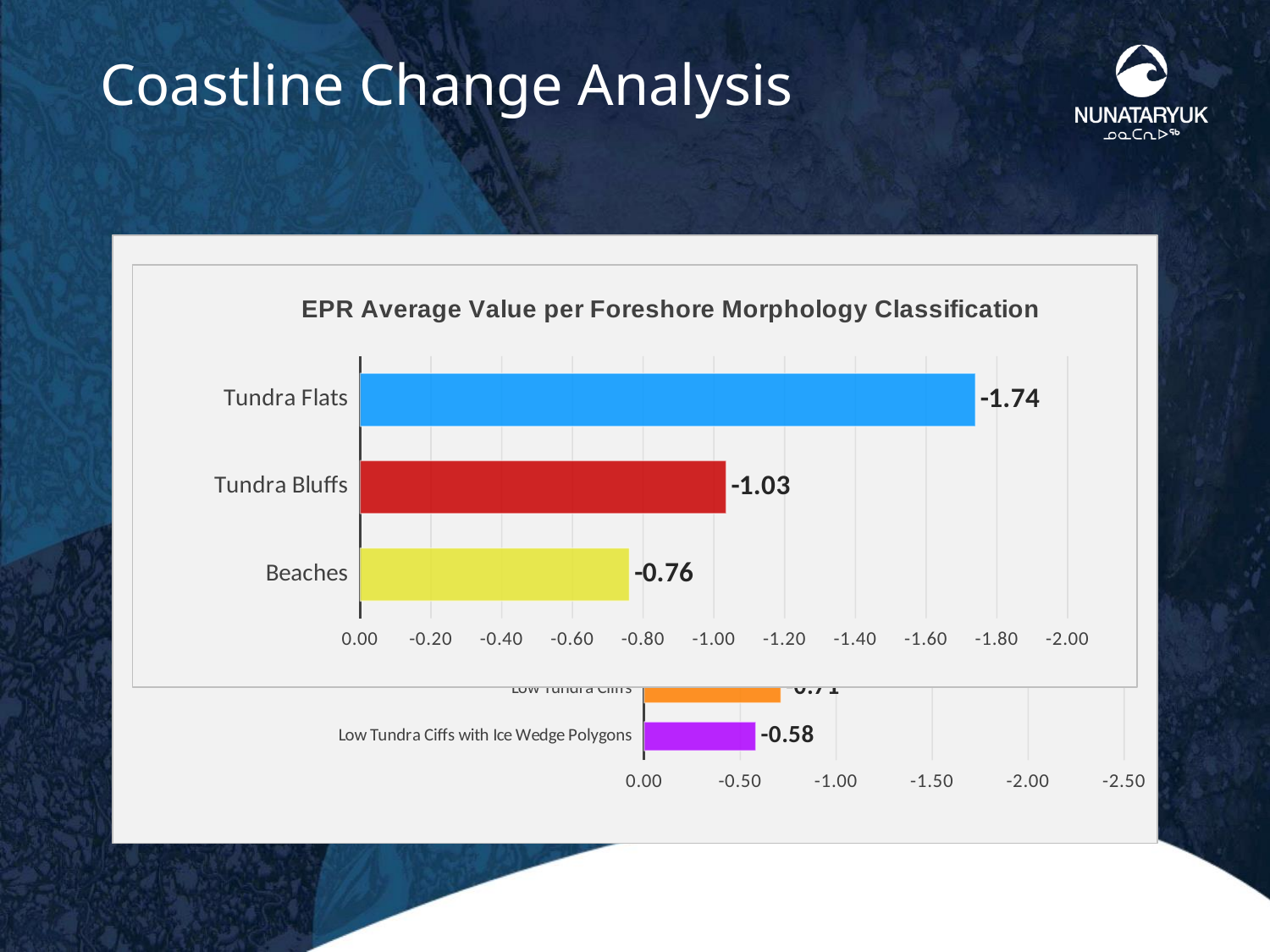
What is the title of the chart on the slide? EPR Average Value per Foreshore Morphology Classification Which foreshore morphology classification has the EPR average value closest to zero (the shortest bar)? Beaches What colour is the bar for Tundra Bluffs? Red Which foreshore morphology classification has the most negative EPR average value (the longest bar)? Tundra Flats How many foreshore morphology classifications are shown in the EPR Average Value chart? 3 What is the difference in magnitude between the EPR average values for Tundra Flats and Tundra Bluffs? 0.71 Which has the larger magnitude of EPR average value, Tundra Bluffs or Beaches? Tundra Bluffs What is the EPR average value for Beaches? -0.76 What type of chart is used to show the EPR average values? Bar chart What is the EPR average value for Tundra Bluffs? -1.03 What is the EPR average value for Tundra Flats? -1.74 What is the difference in magnitude between the EPR average values for Tundra Bluffs and Beaches? 0.27